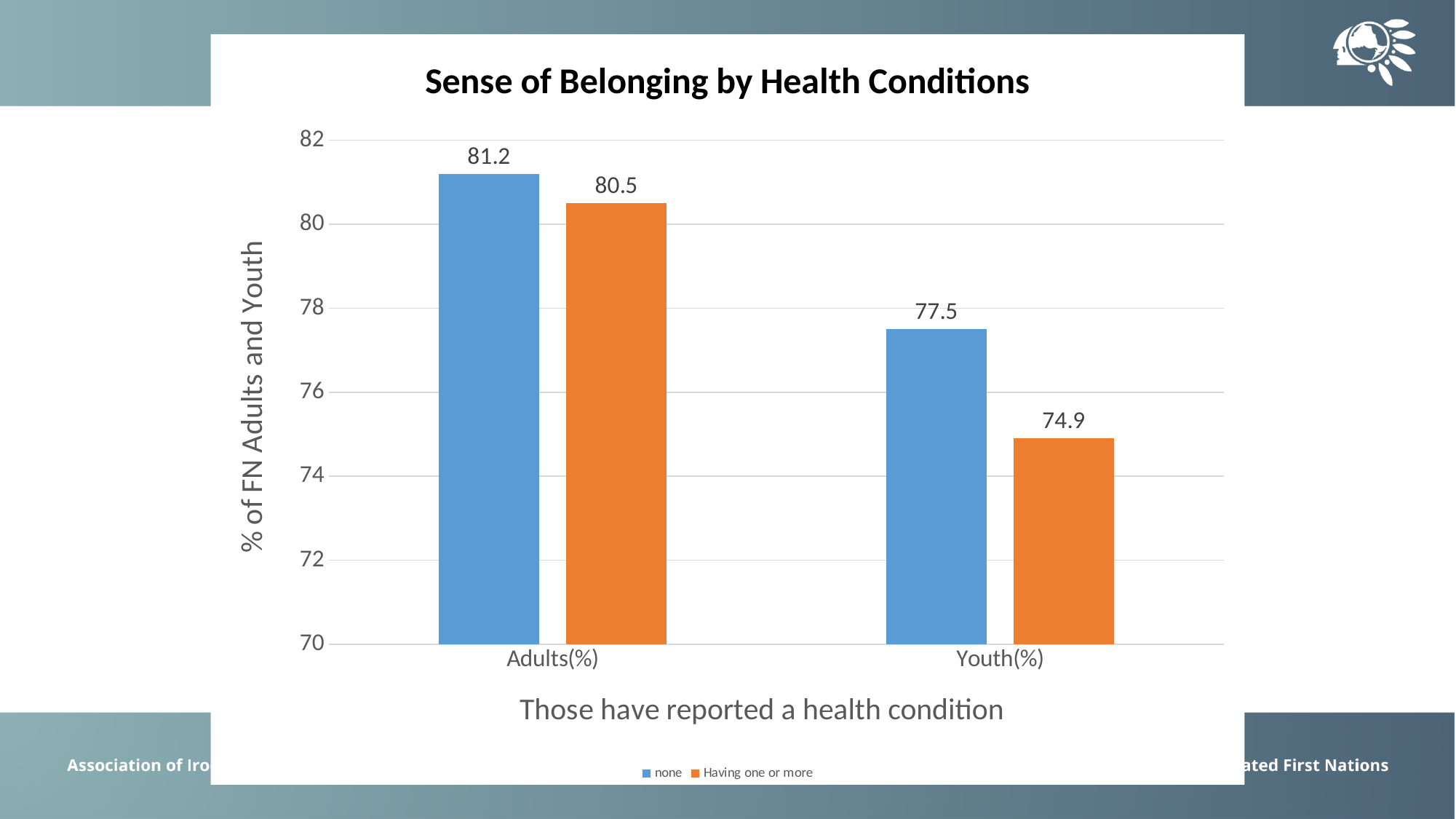
What type of chart is shown on the slide? Bar chart How many series does the legend list? 2 How many categories are shown on the x axis? 2 What is the difference between the "none" values for Adults(%) and Youth(%)? 3.7 Is the "Having one or more" value for Youth(%) greater or less than 76? less What is the value for "Having one or more" in the Adults(%) category? 80.5 What is the value for "Having one or more" in the Youth(%) category? 74.9 Which is larger: the "none" value for Youth(%) or the "Having one or more" value for Adults(%)? Having one or more for Adults(%) What is the value for "none" in the Adults(%) category? 81.2 What is the difference between the "none" and "Having one or more" values for Youth(%)? 2.6 Which bar has the lowest value on the chart? Having one or more, Youth(%) Which category has the highest value for the "none" series? Adults(%)